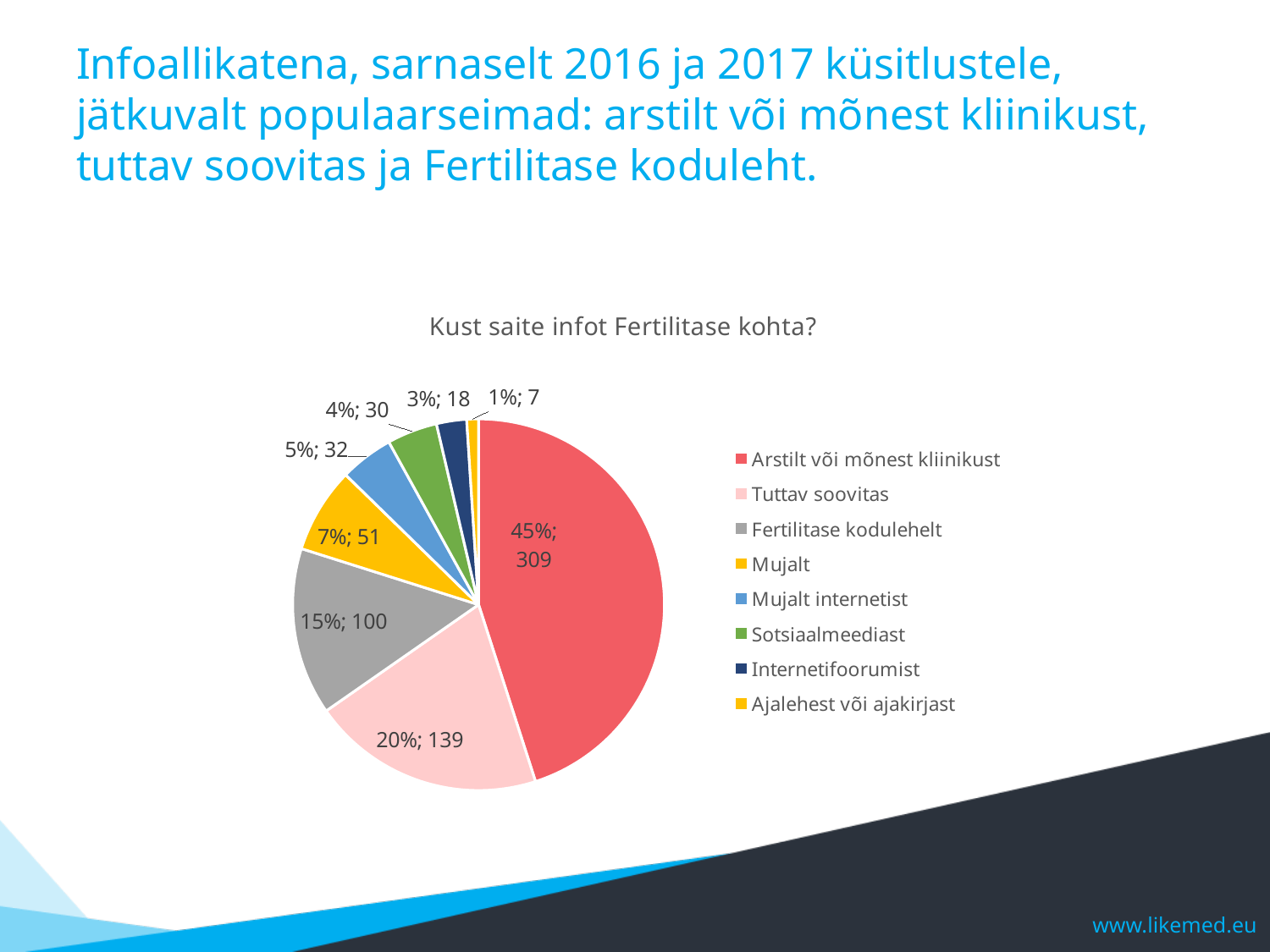
What is the count shown for "Internetifoorumist"? 18 What kind of chart is shown on the slide? Pie chart What is the count shown for "Arstilt või mõnest kliinikust"? 309 What is the count shown for "Fertilitase kodulehelt"? 100 Which category has the smallest slice in the pie chart? Ajalehest või ajakirjast How many categories does the legend of the pie chart list? 8 What percentage share does "Tuttav soovitas" have in the pie chart? 20% What percentage share does "Mujalt" have in the pie chart? 7% Which category has the largest slice in the pie chart? Arstilt või mõnest kliinikust What is the difference in count between "Arstilt või mõnest kliinikust" and "Tuttav soovitas"? 170 What is the title of the chart? Kust saite infot Fertilitase kohta? Which has a larger count, "Mujalt internetist" or "Sotsiaalmeediast"? Mujalt internetist